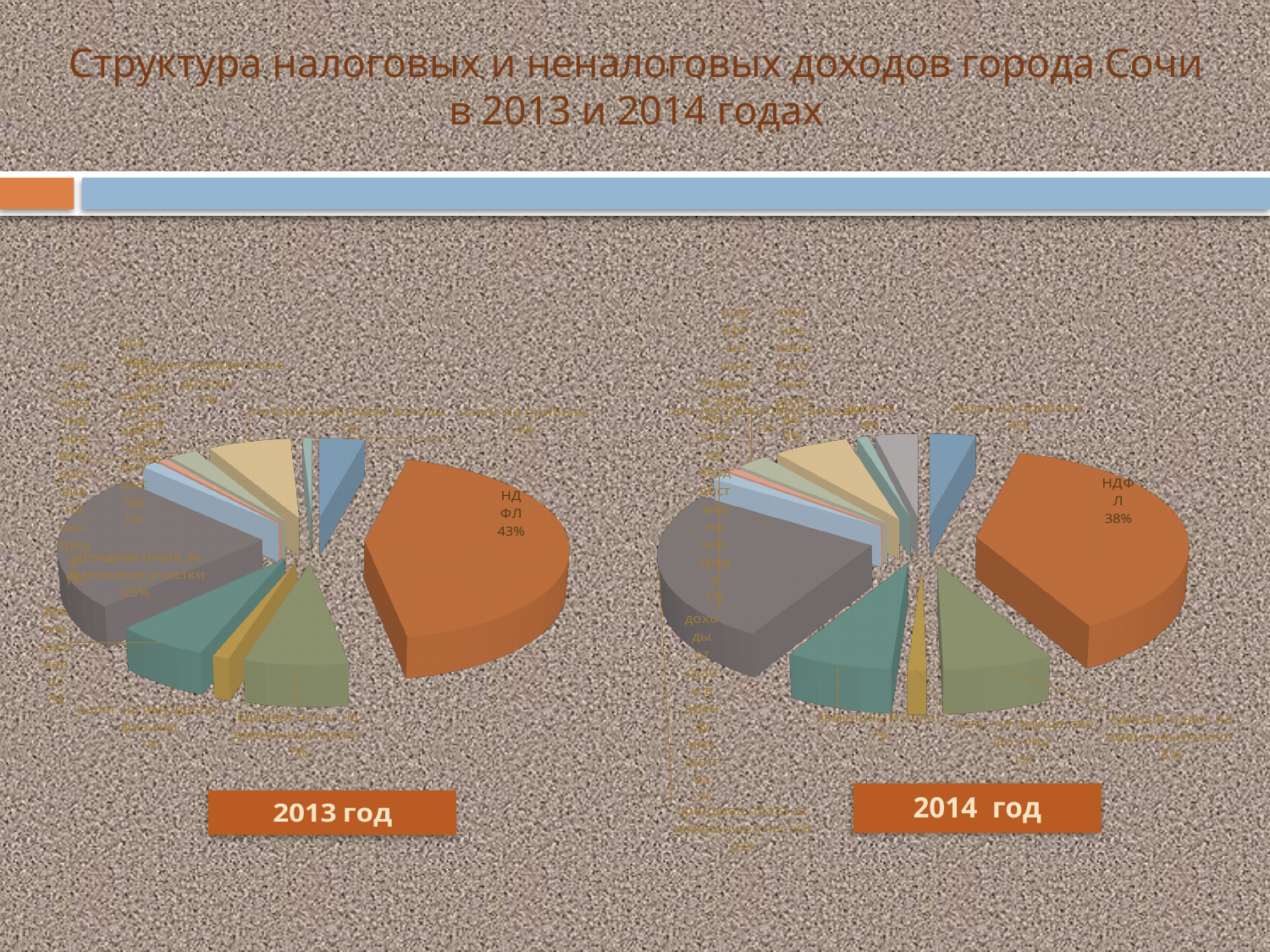
In the 2014 год chart, is the share of НДФЛ greater or less than 40%? less How many charts are shown on the slide? 2 What kind of chart is used on the slide for the 2013 год data? pie chart In the 2013 год chart, what share does НДФЛ have? 43% In the 2014 год chart, which category has the largest slice? НДФЛ What colour is the НДФЛ slice in the 2013 год chart? orange In the 2014 год chart, what share does НДФЛ have? 38% In the 2013 год chart, which category has the largest slice? НДФЛ Is the share of НДФЛ larger in the 2013 год chart or the 2014 год chart? 2013 год By how many percentage points does the НДФЛ share in the 2013 год chart exceed the НДФЛ share in the 2014 год chart? 5 What is the title of the slide containing the two pie charts? Структура налоговых и неналоговых доходов города Сочи в 2013 и 2014 годах